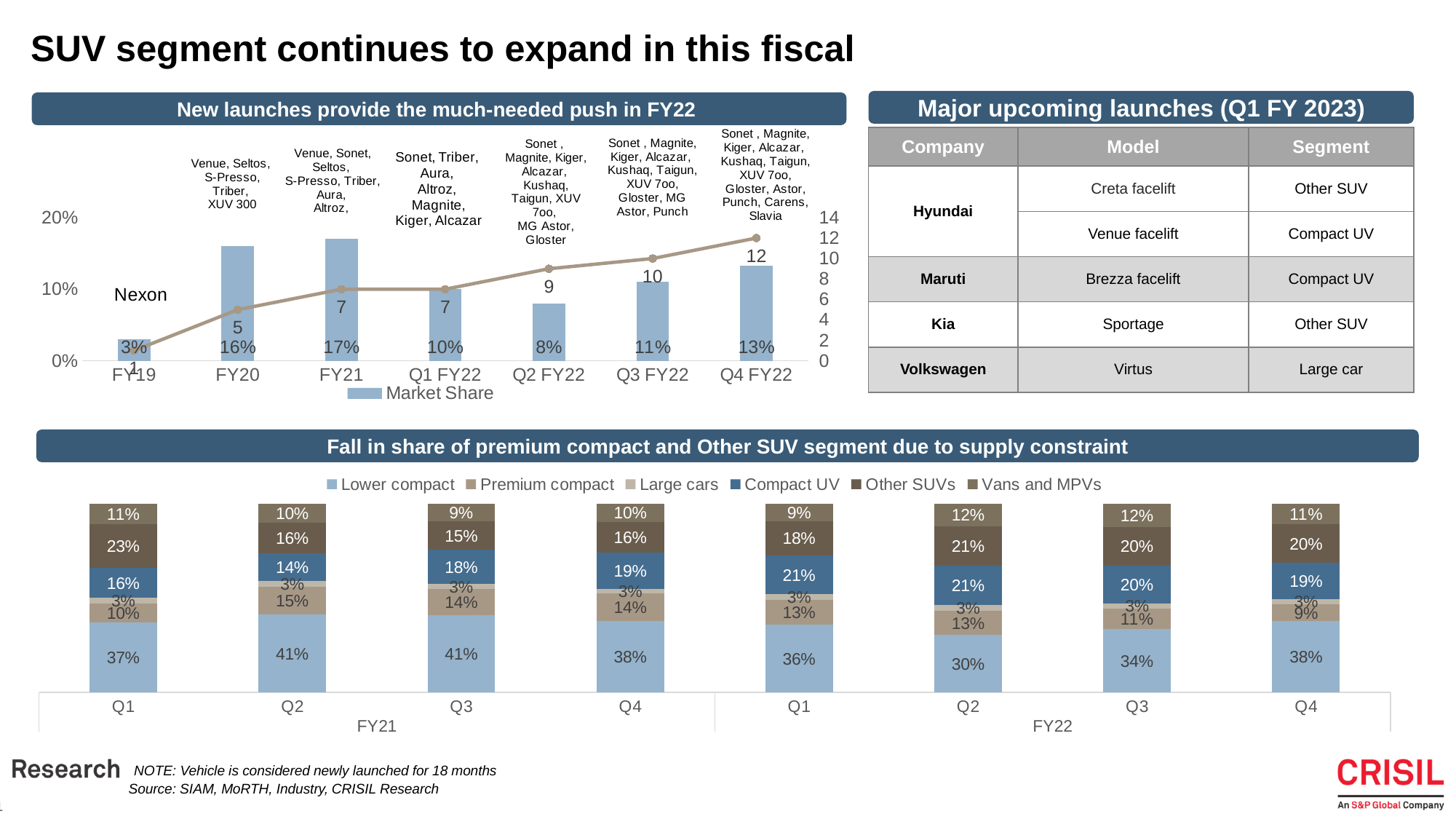
In the chart titled 'New launches provide the much-needed push in FY22', how many periods are shown on the x axis? 7 In the chart titled 'New launches provide the much-needed push in FY22', which period has the lowest market share? FY19 In the chart titled 'Fall in share of premium compact and Other SUV segment due to supply constraint', which quarter has the highest Lower compact share? Q2 FY21 and Q3 FY21 (41%) In the chart titled 'Fall in share of premium compact and Other SUV segment due to supply constraint', what is the difference in Premium compact share between Q2 FY21 and Q4 FY22? 6% In the chart titled 'Fall in share of premium compact and Other SUV segment due to supply constraint', how many series does the legend list? 6 In the chart titled 'New launches provide the much-needed push in FY22', what is the value of the line for Q4 FY22? 12 What kind of chart is the one titled 'Fall in share of premium compact and Other SUV segment due to supply constraint'? Stacked bar chart In the chart titled 'New launches provide the much-needed push in FY22', what is the market share for FY21? 17% In the chart titled 'New launches provide the much-needed push in FY22', what is the difference in market share between Q4 FY22 and Q2 FY22? 5% In the chart titled 'Fall in share of premium compact and Other SUV segment due to supply constraint', is the Compact UV share larger in Q1 FY21 or Q1 FY22? Q1 FY22 In the chart titled 'Fall in share of premium compact and Other SUV segment due to supply constraint', what is the share of Lower compact in Q2 FY22? 30% In the chart titled 'Fall in share of premium compact and Other SUV segment due to supply constraint', what is the share of Other SUVs in Q1 FY21? 23%